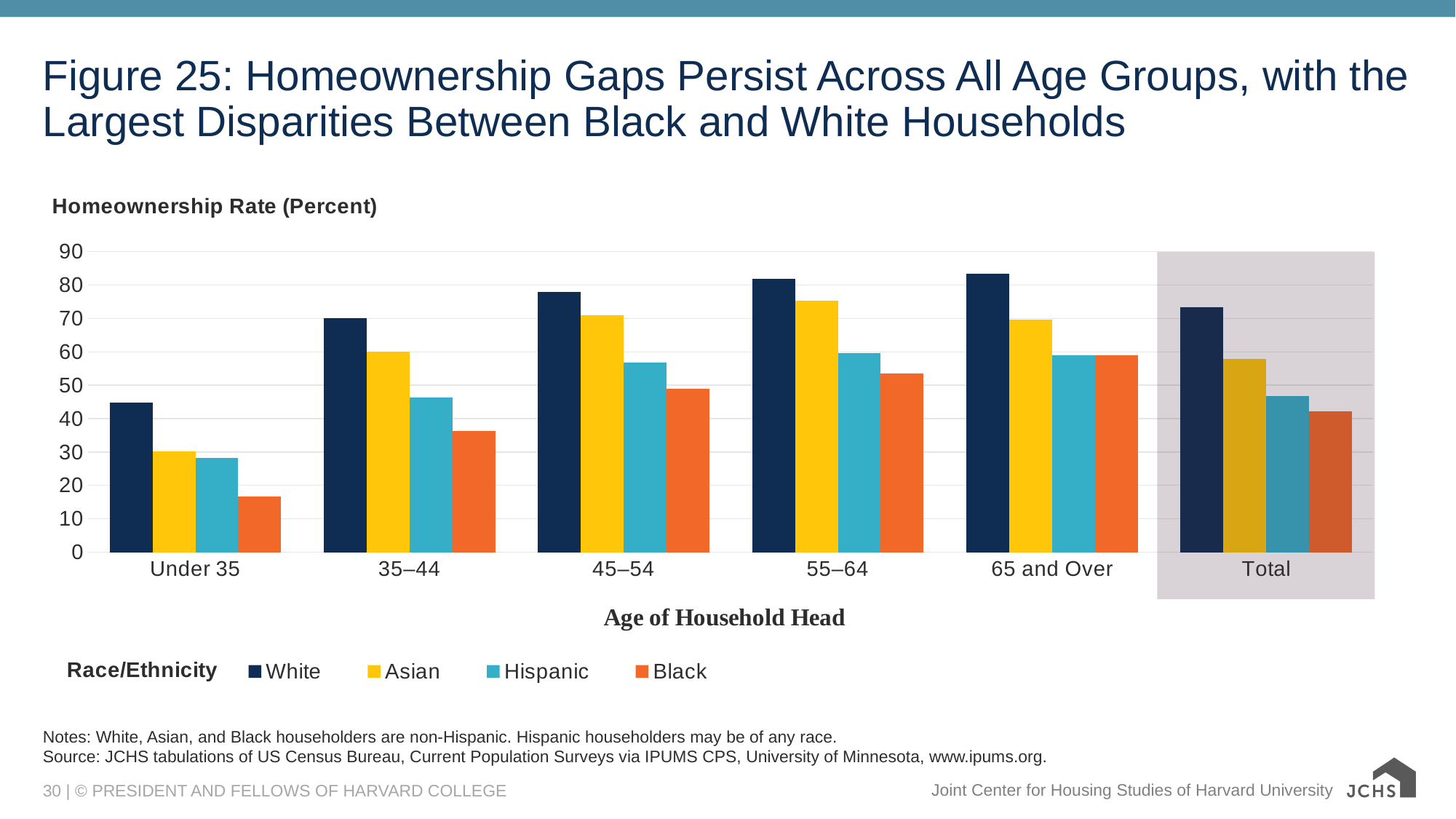
In the 35–44 age group, which is larger: the Asian or the Hispanic homeownership rate? Asian Is the homeownership rate for Asian households aged 55–64 greater or less than 70? greater How many series does the legend list? 4 Is the homeownership rate for Black households in the Total category greater or less than 50? less Is the homeownership rate for Black households Under 35 greater or less than 20? less How many age-group categories are shown on the x axis, including Total? 6 Which race/ethnicity has the highest homeownership rate in the Under 35 group? White Does the White homeownership rate rise or fall from Under 35 through 65 and Over? Rises Which category on the x axis is highlighted with grey shading? Total Which race/ethnicity has the lowest homeownership rate in the Under 35 group? Black What kind of chart is shown on the slide? Bar chart